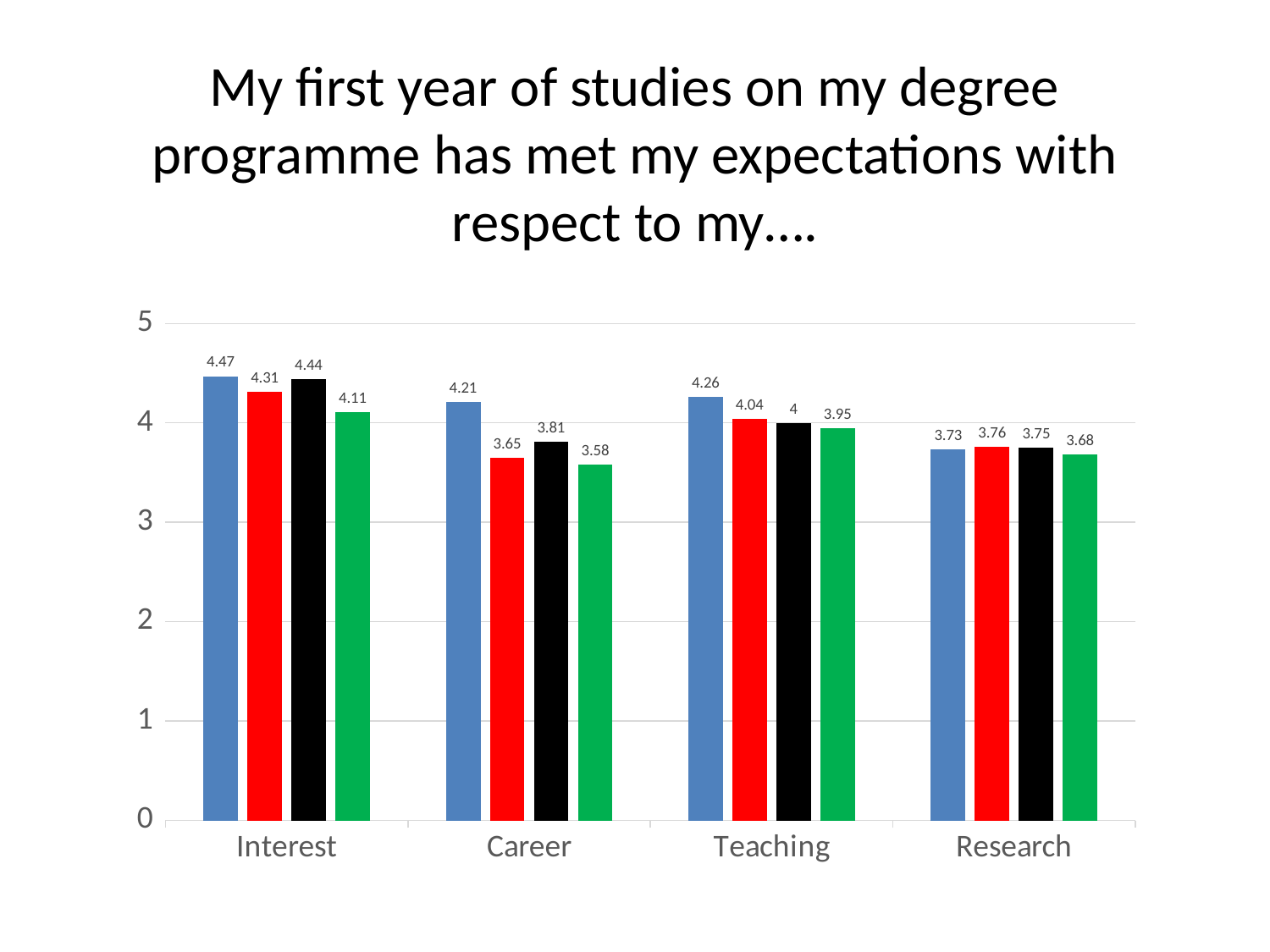
Is the value of the blue bar for Research greater or less than 4? less What is the value of the red bar for Research? 3.76 Which category has the lowest green bar? Career What is the difference between the blue bar and the red bar for Career? 0.56 What kind of chart is shown on the slide? bar chart What is the value of the green bar for Career? 3.58 What is the value of the black bar for Teaching? 4 How many categories are shown on the x axis? 4 Which category has the highest blue bar? Interest How many bars are shown for each category? 4 What is the value of the blue bar for Interest? 4.47 Which is larger for Interest, the red bar or the black bar? the black bar